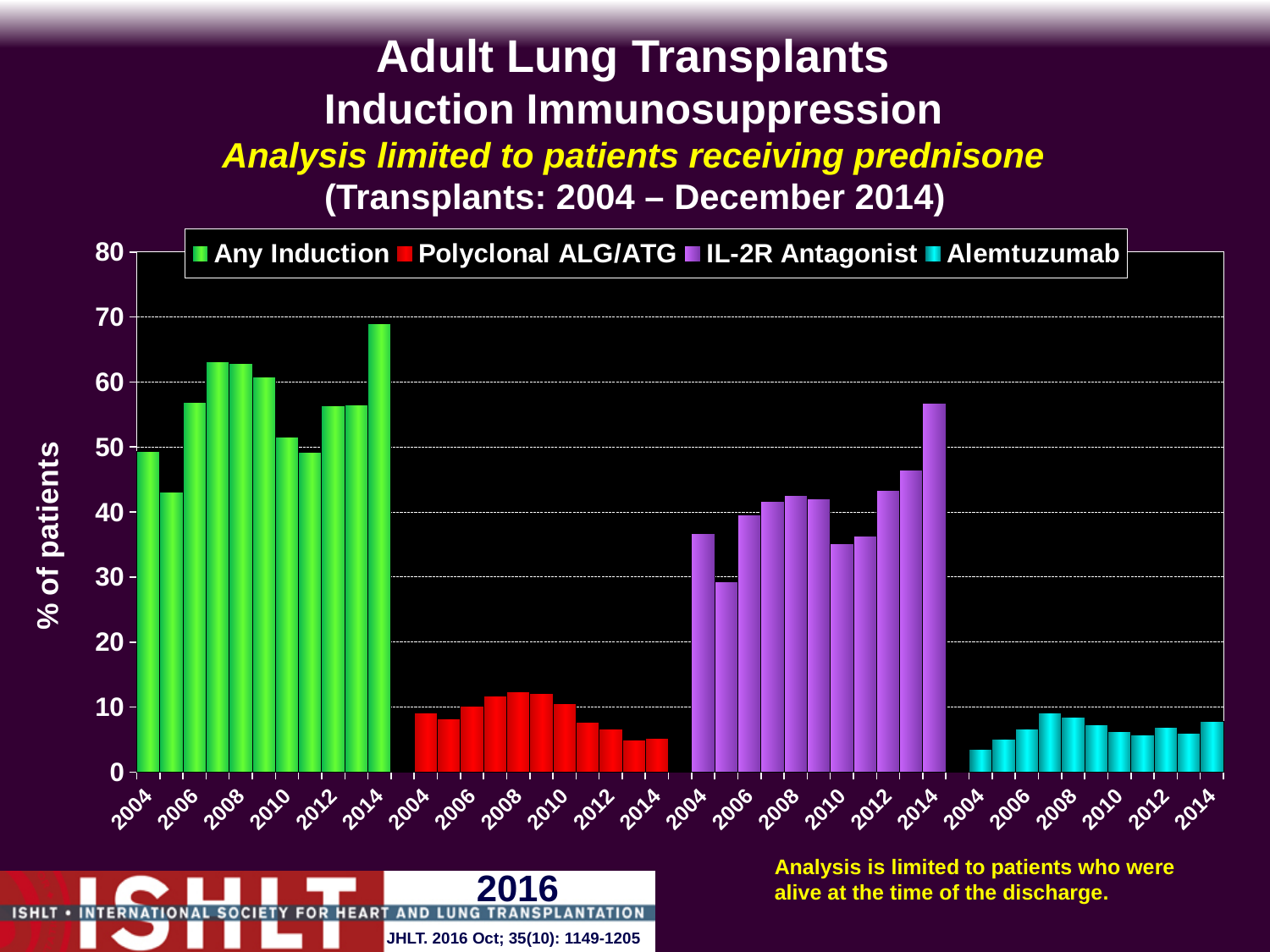
Which is larger in 2014: the Any Induction value or the IL-2R Antagonist value? Any Induction How many series does the legend list? 4 How many years are plotted for the Any Induction series? 11 What is the label on the y axis? % of patients In which year is the Any Induction value highest? 2014 In which year is the Any Induction value lowest? 2005 In which year is the IL-2R Antagonist value lowest? 2005 What kind of chart is shown on the slide? bar chart In which year is the IL-2R Antagonist value highest? 2014 In which year is the Alemtuzumab value lowest? 2004 Is the Any Induction value for 2014 greater or less than 60? greater